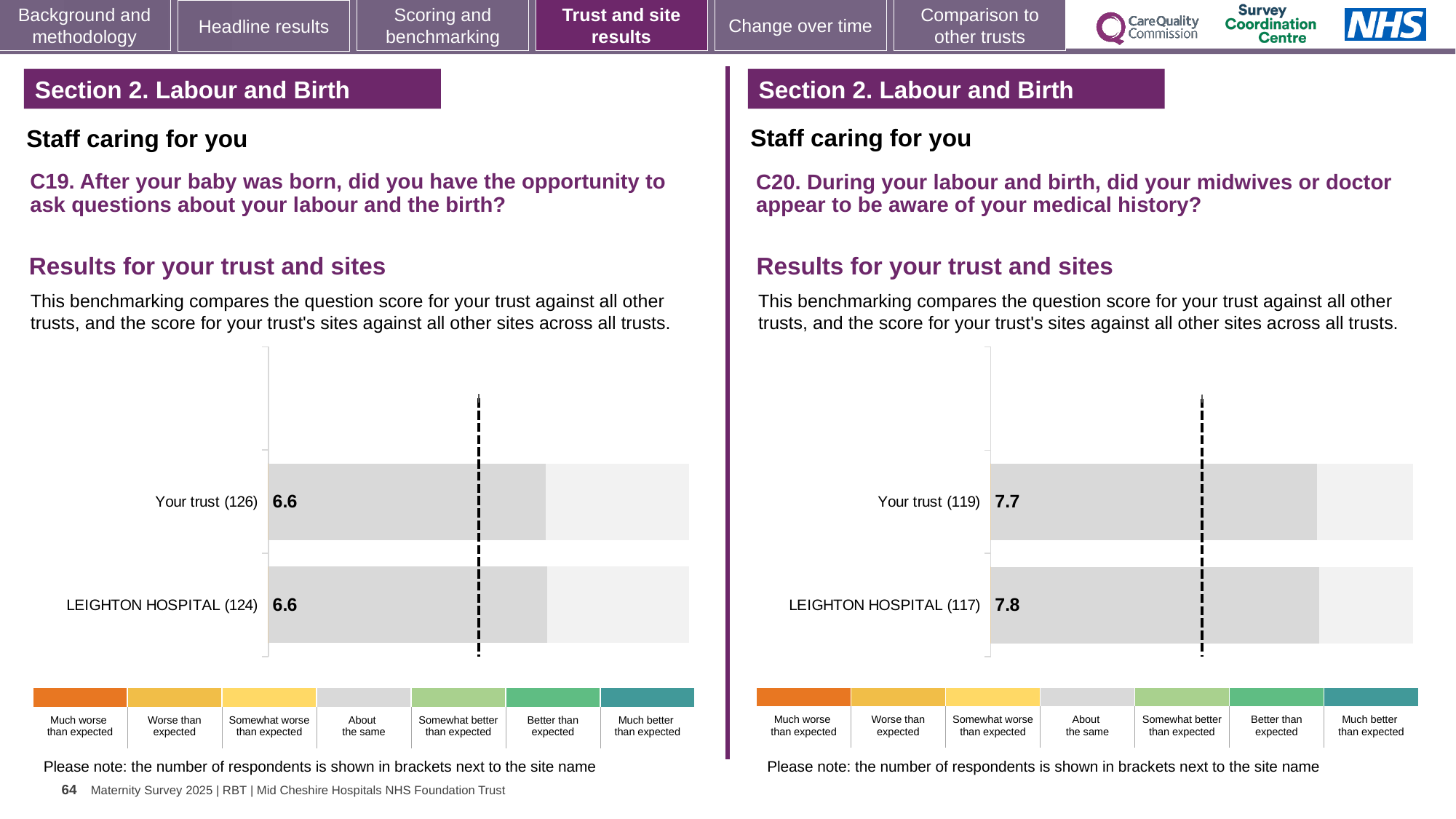
In the C20 chart on the right, which has the higher score, Your trust or LEIGHTON HOSPITAL? LEIGHTON HOSPITAL In the C20 chart on the right, what is the score for LEIGHTON HOSPITAL? 7.8 In the C19 chart on the left, what is the score for LEIGHTON HOSPITAL? 6.6 How many bars are plotted in the C20 chart on the right? 2 In the C20 chart on the right, how many respondents are shown in brackets for LEIGHTON HOSPITAL? 117 How many bars are plotted in the C19 chart on the left? 2 In the C19 chart on the left, is the score for Your trust larger than, smaller than, or equal to the score for LEIGHTON HOSPITAL? equal In the C19 chart on the left, what is the score for Your trust? 6.6 In the C20 chart on the right, what is the score for Your trust? 7.7 In the C20 chart on the right, what is the difference between the LEIGHTON HOSPITAL score and the Your trust score? 0.1 In the C19 chart on the left, how many respondents are shown in brackets for Your trust? 126 What type of chart is used for the C20 results on the right? Bar chart